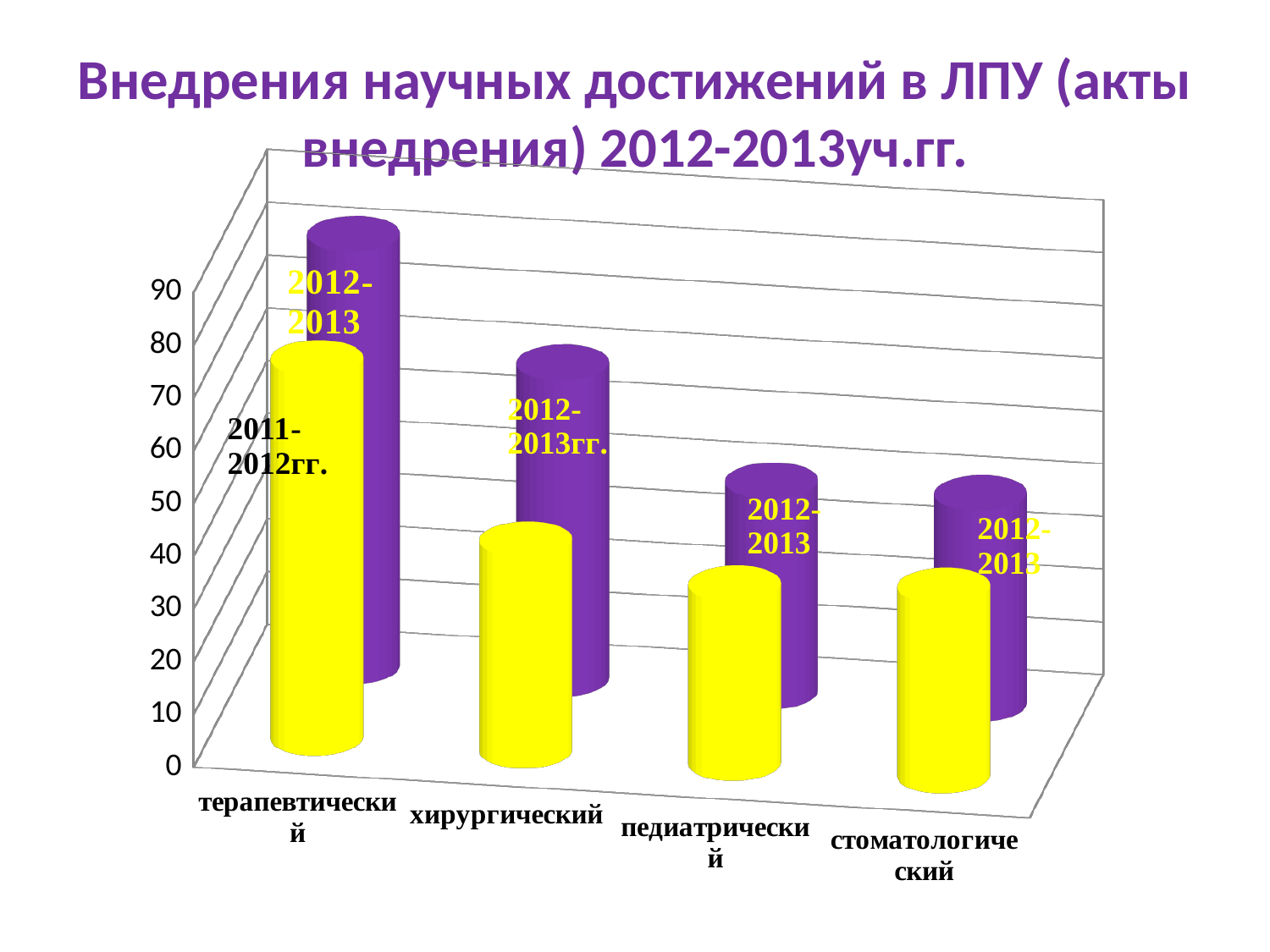
How many data series are plotted in the chart? 2 How many categories (departments) are shown on the x axis? 4 Which category has the highest value for the 2011-2012 series? терапевтический Is the 2011-2012 value for терапевтический greater or less than 60? greater Which colour represents the 2012-2013 series? purple What kind of chart is shown on the slide? bar chart Do the 2012-2013 values rise or fall moving from терапевтический to стоматологический along the x axis? fall Is the 2011-2012 value for педиатрический greater or less than 50? less For хирургический, which series has the larger value, 2011-2012 or 2012-2013? 2012-2013 What is the title of the chart? Внедрения научных достижений в ЛПУ (акты внедрения) 2012-2013уч.гг. Is the 2011-2012 value for хирургический greater or less than 60? less Which category has the highest value for the 2012-2013 series? терапевтический